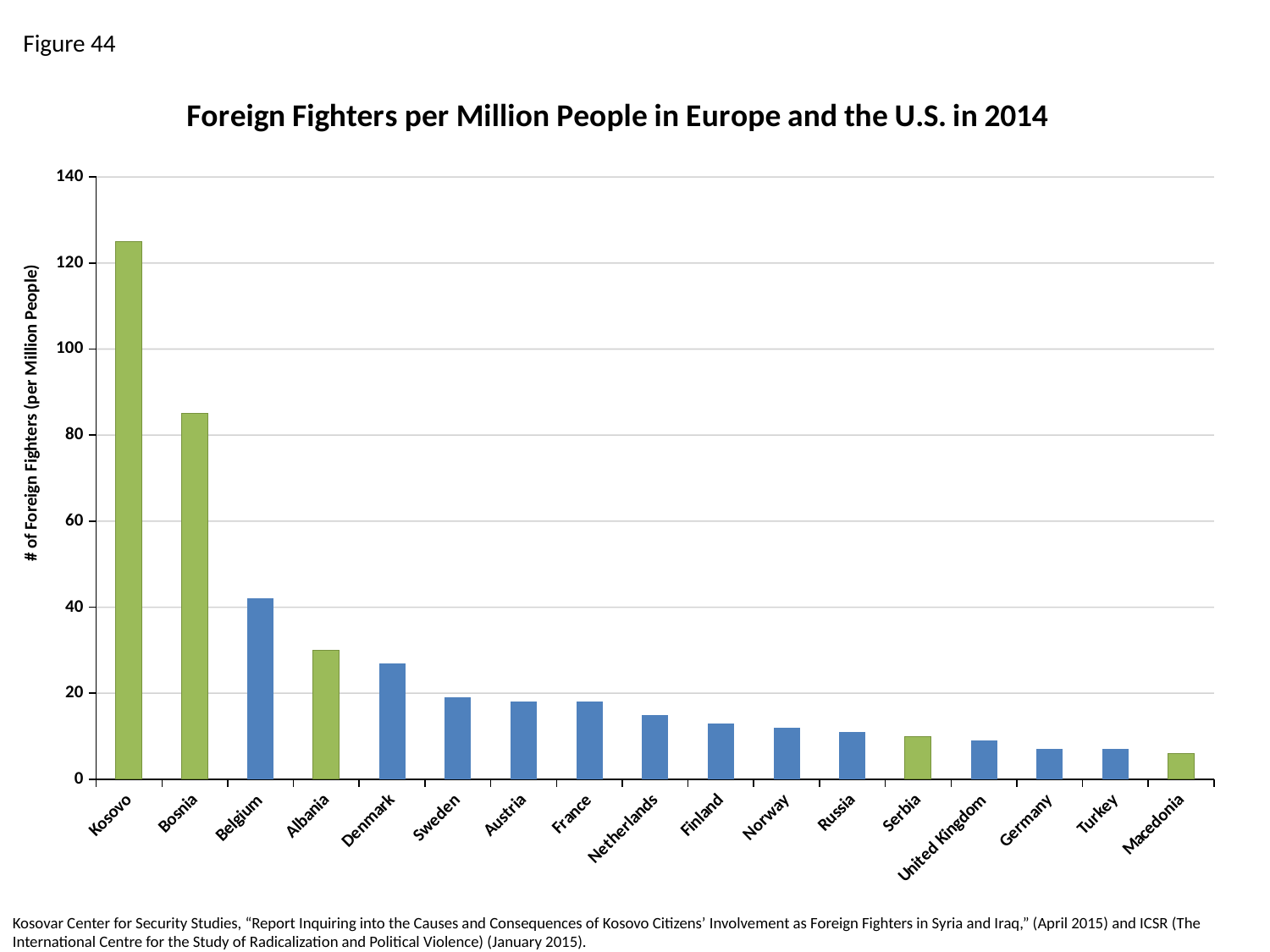
What kind of chart is shown on the slide? bar chart Is the value for Kosovo greater or less than 120? greater Which has a higher value, Bosnia or Denmark? Bosnia What is the title of the chart? Foreign Fighters per Million People in Europe and the U.S. in 2014 Do the values rise or fall moving from left to right along the x axis? fall Which country has the highest number of foreign fighters per million people? Kosovo Is the value for Bosnia greater or less than 80? greater How many countries are shown on the x axis of the chart? 17 Which has a higher value, Belgium or Albania? Belgium Is the value for Denmark greater or less than 40? less